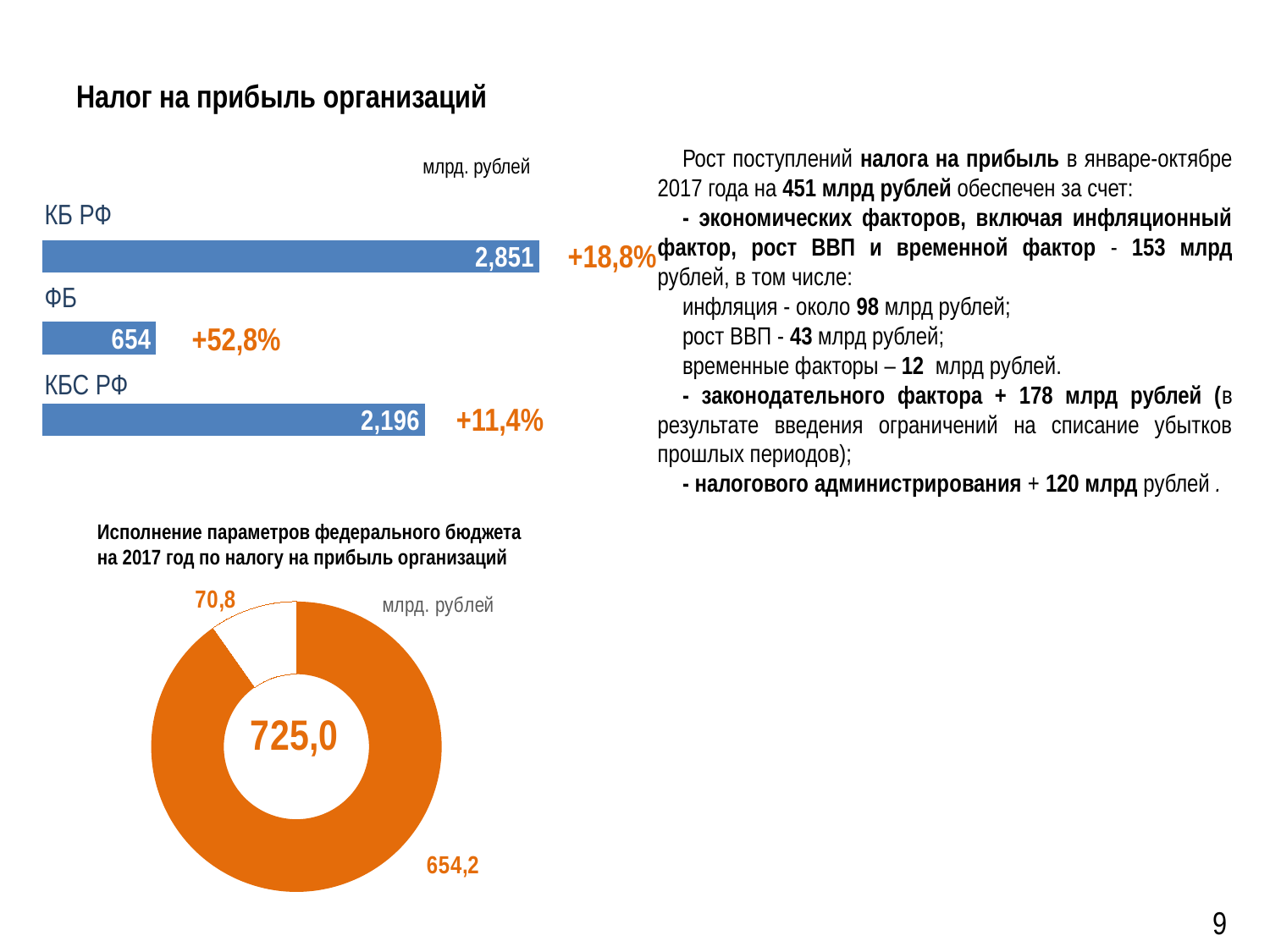
In the bar chart at the top left, what is the value for КБС РФ? 2,196 In the bar chart at the top left, what is the difference between the values for КБ РФ and КБС РФ? 655 In the bar chart at the top left, which category has the highest value? КБ РФ In the bar chart at the top left, what is the value for КБ РФ? 2,851 In the doughnut chart at the bottom left, what total is shown in the centre? 725,0 In the bar chart at the top left, which category has the lowest value? ФБ In the doughnut chart at the bottom left, what is the value of the larger (orange) segment? 654,2 In the bar chart at the top left, what growth percentage is shown next to the КБС РФ bar? +11,4% What kind of chart is shown at the bottom left of the slide? Doughnut chart In the bar chart at the top left, what is the value for ФБ? 654 In the bar chart at the top left, what growth percentage is shown next to the ФБ bar? +52,8% In the bar chart at the top left, how many categories are shown? 3